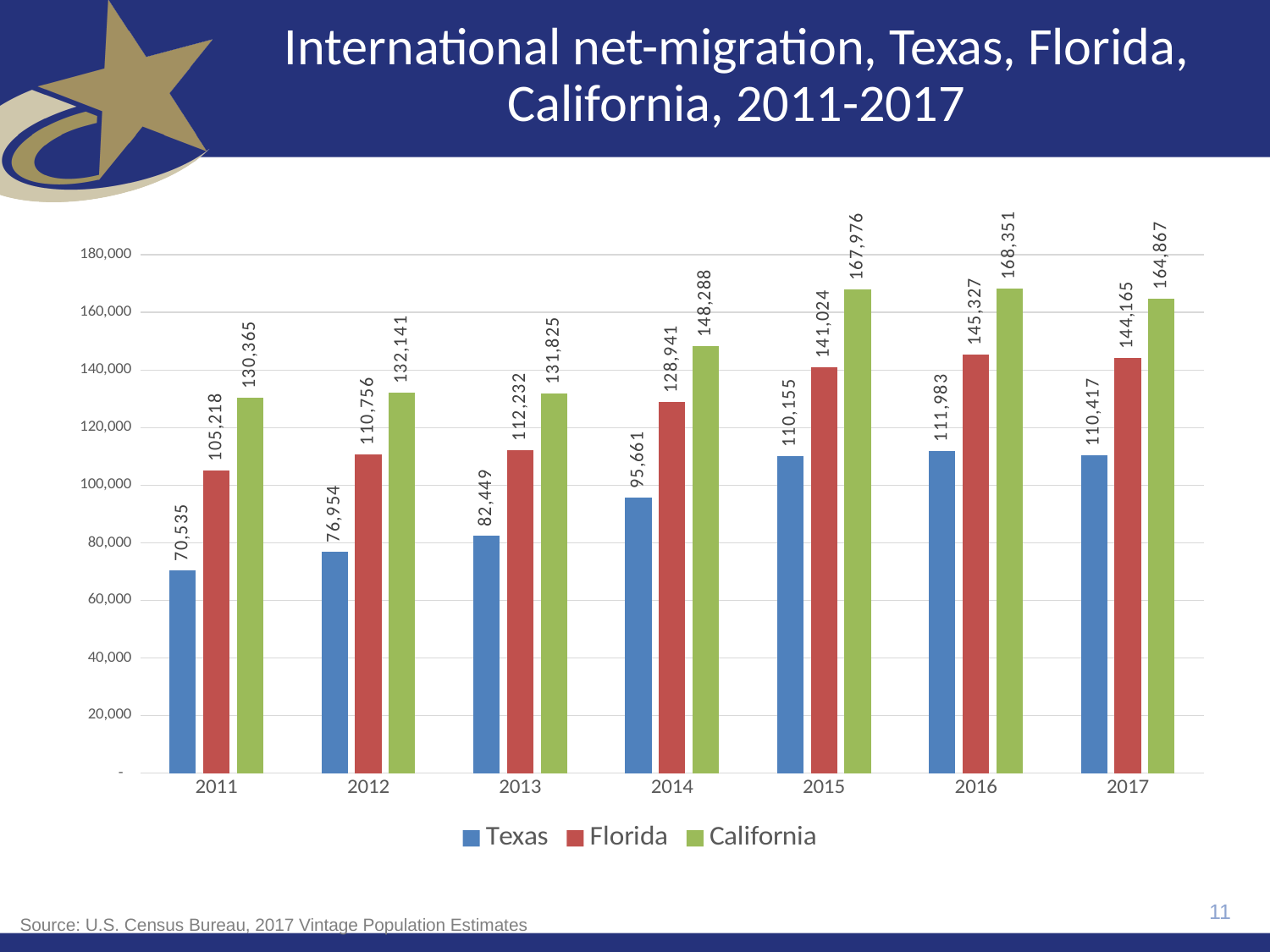
What was the international net-migration for Florida in 2014? 128,941 How many series does the legend list? 3 How many years are shown on the x axis? 7 Which state had higher international net-migration in 2013, Florida or Texas? Florida What was the international net-migration for California in 2016? 168,351 What was the international net-migration for Texas in 2011? 70,535 What is the difference between California's and Texas's international net-migration in 2015? 57,821 In which year was Texas's international net-migration highest? 2016 In which year was California's international net-migration lowest? 2011 Which colour represents California in the chart? Green What kind of chart is shown on the slide? Bar chart Did Texas's international net-migration rise or fall from 2011 to 2015? Rise